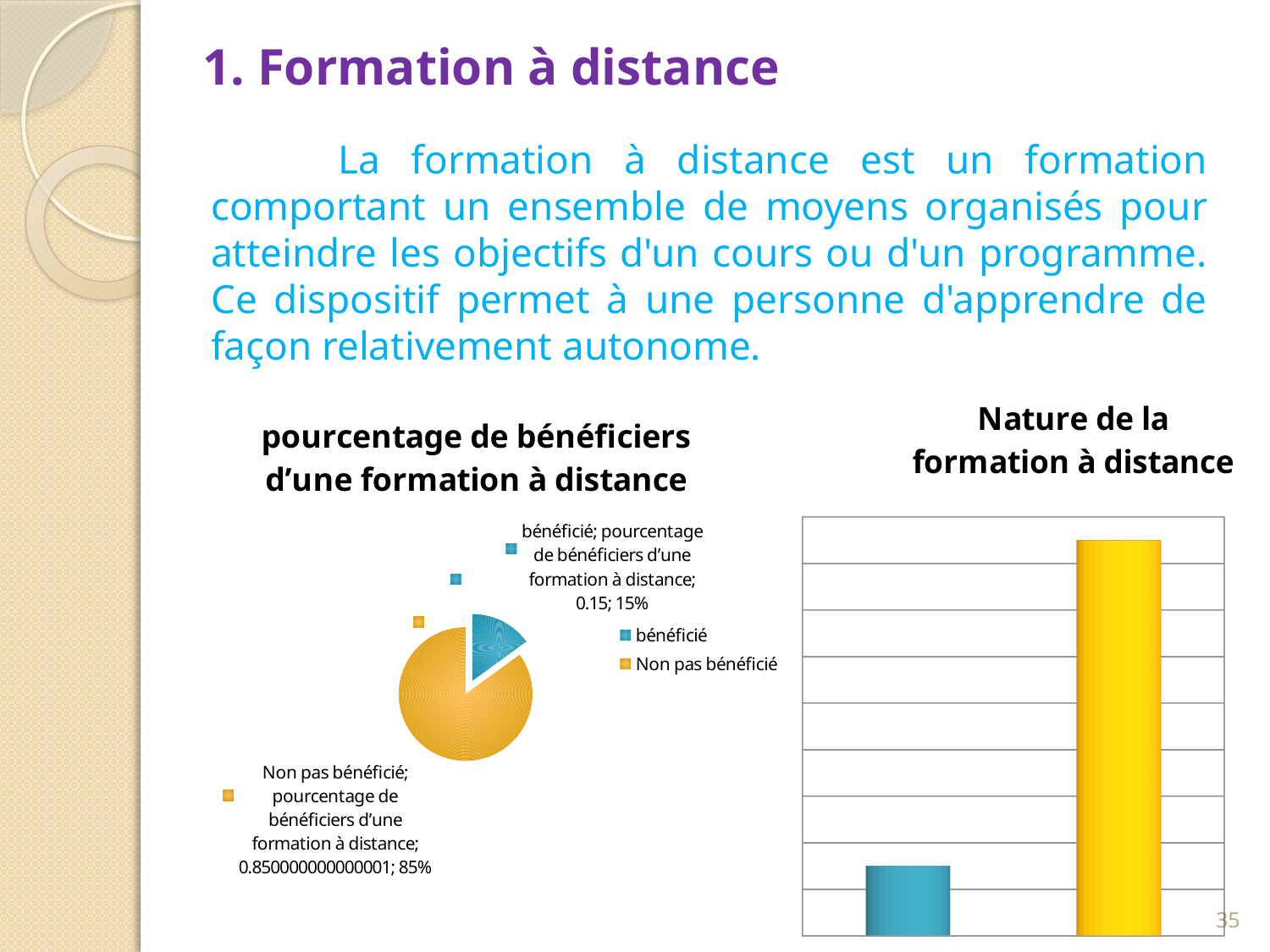
In the chart titled 'pourcentage de bénéficiers d'une formation à distance', what share of the pie is 'bénéficié'? 15% In the chart titled 'pourcentage de bénéficiers d'une formation à distance', which category has the largest slice? Non pas bénéficié In the chart titled 'pourcentage de bénéficiers d'une formation à distance', what share of the pie is 'Non pas bénéficié'? 85% In the chart titled 'pourcentage de bénéficiers d'une formation à distance', which category has the smallest slice? bénéficié In the chart titled 'pourcentage de bénéficiers d'une formation à distance', how many entries does the legend list? 2 In the chart titled 'pourcentage de bénéficiers d'une formation à distance', how many slices does the pie have? 2 What kind of chart is the chart titled 'Nature de la formation à distance'? bar chart In the chart titled 'pourcentage de bénéficiers d'une formation à distance', what is the difference in percentage points between 'Non pas bénéficié' and 'bénéficié'? 70% In the chart titled 'Nature de la formation à distance', which bar is taller: the blue bar or the yellow bar? the yellow bar In the chart titled 'pourcentage de bénéficiers d'une formation à distance', which is larger: 'bénéficié' or 'Non pas bénéficié'? Non pas bénéficié In the chart titled 'Nature de la formation à distance', how many bars are plotted? 2 What kind of chart is the chart titled 'pourcentage de bénéficiers d'une formation à distance'? pie chart